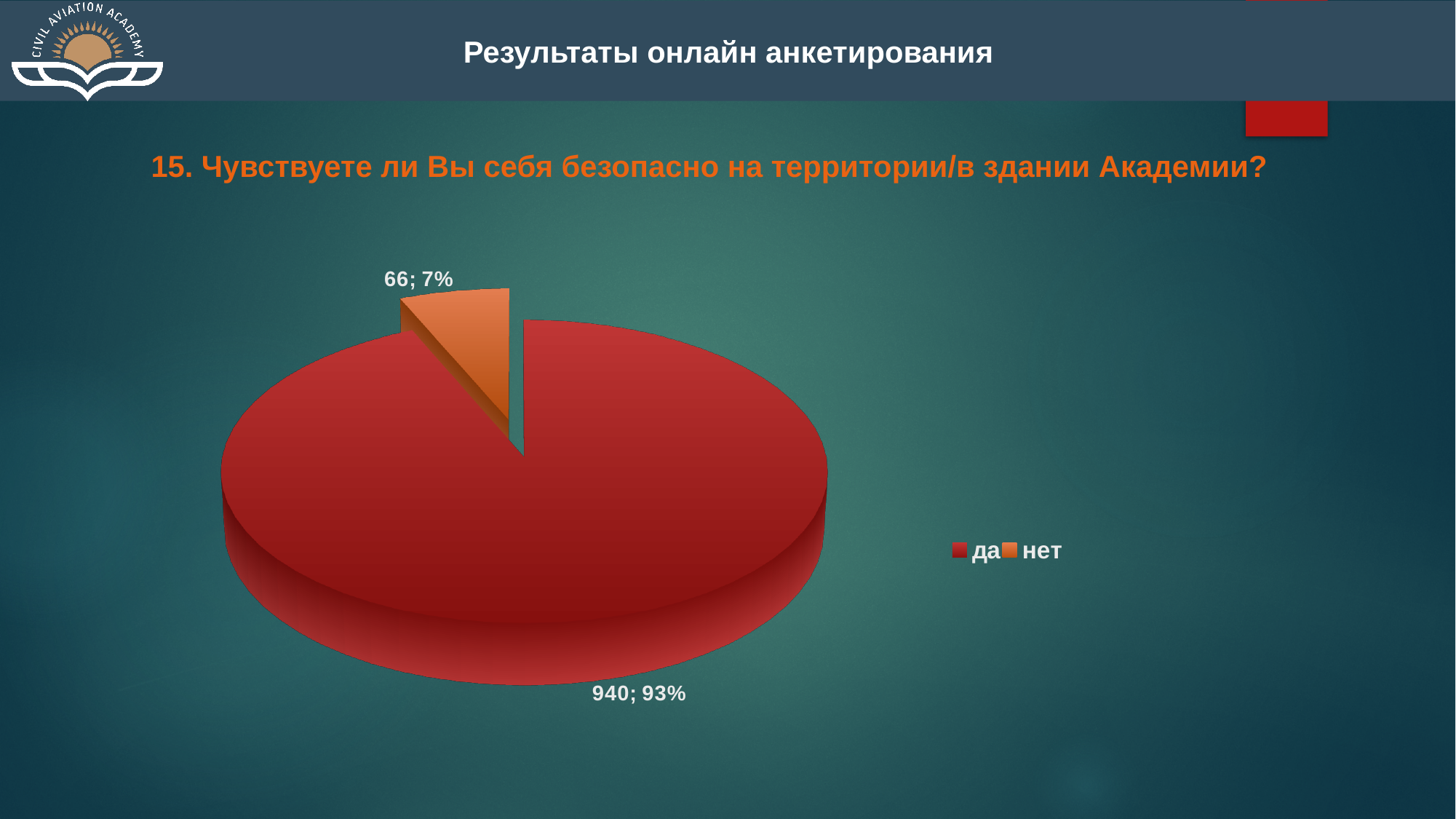
Which colour represents "нет" in the pie chart? orange What is the count for "да"? 940 What is the total number of responses shown in the pie chart? 1006 How many entries does the legend list? 2 What share of the pie does "да" represent? 93% What kind of chart is shown on the slide? pie chart What is the count for "нет"? 66 Which category has the smallest slice? нет What is the difference between the counts for "да" and "нет"? 874 How many slices does the pie chart have? 2 Which category has the largest slice? да What share of the pie does "нет" represent? 7%